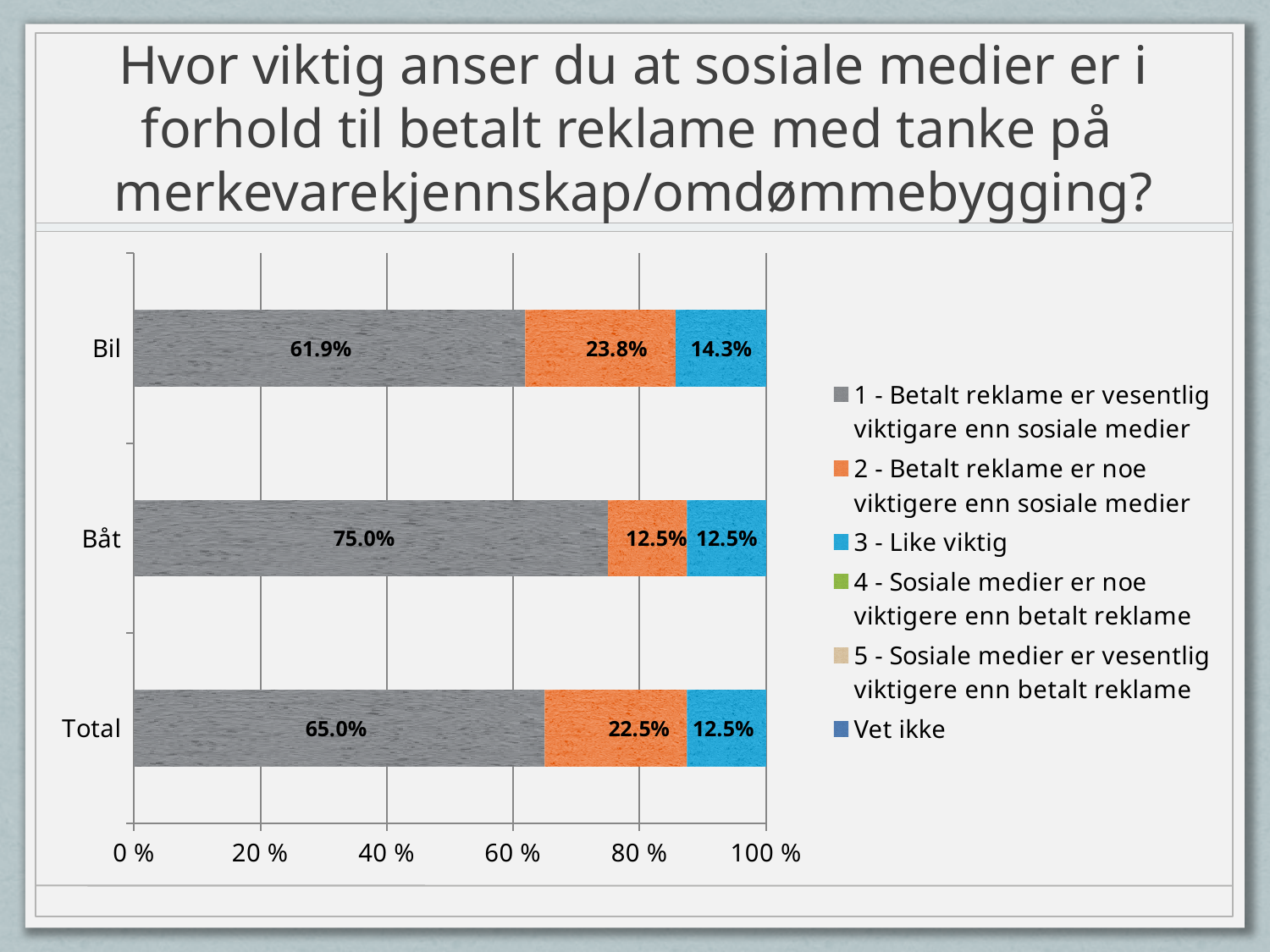
Which is larger: the '3 - Like viktig' value for Bil or for Total? Bil How many categories are plotted on the vertical axis? 3 What is the value for Total in the series '3 - Like viktig'? 12.5% What is the difference between the '1 - Betalt reklame er vesentlig viktigare enn sosiale medier' values for Båt and Bil? 13.1% Is the '1 - Betalt reklame er vesentlig viktigare enn sosiale medier' value for Total greater or less than 60 %? greater What kind of chart is shown on the slide? Stacked bar chart Which category has the highest value for '1 - Betalt reklame er vesentlig viktigare enn sosiale medier'? Båt Which category has the lowest value for '2 - Betalt reklame er noe viktigere enn sosiale medier'? Båt How many series does the legend list? 6 What is the value for Båt in the series '2 - Betalt reklame er noe viktigere enn sosiale medier'? 12.5% What is the value for Bil in the series '1 - Betalt reklame er vesentlig viktigare enn sosiale medier'? 61.9% Which colour represents the series '3 - Like viktig' in the legend? Blue